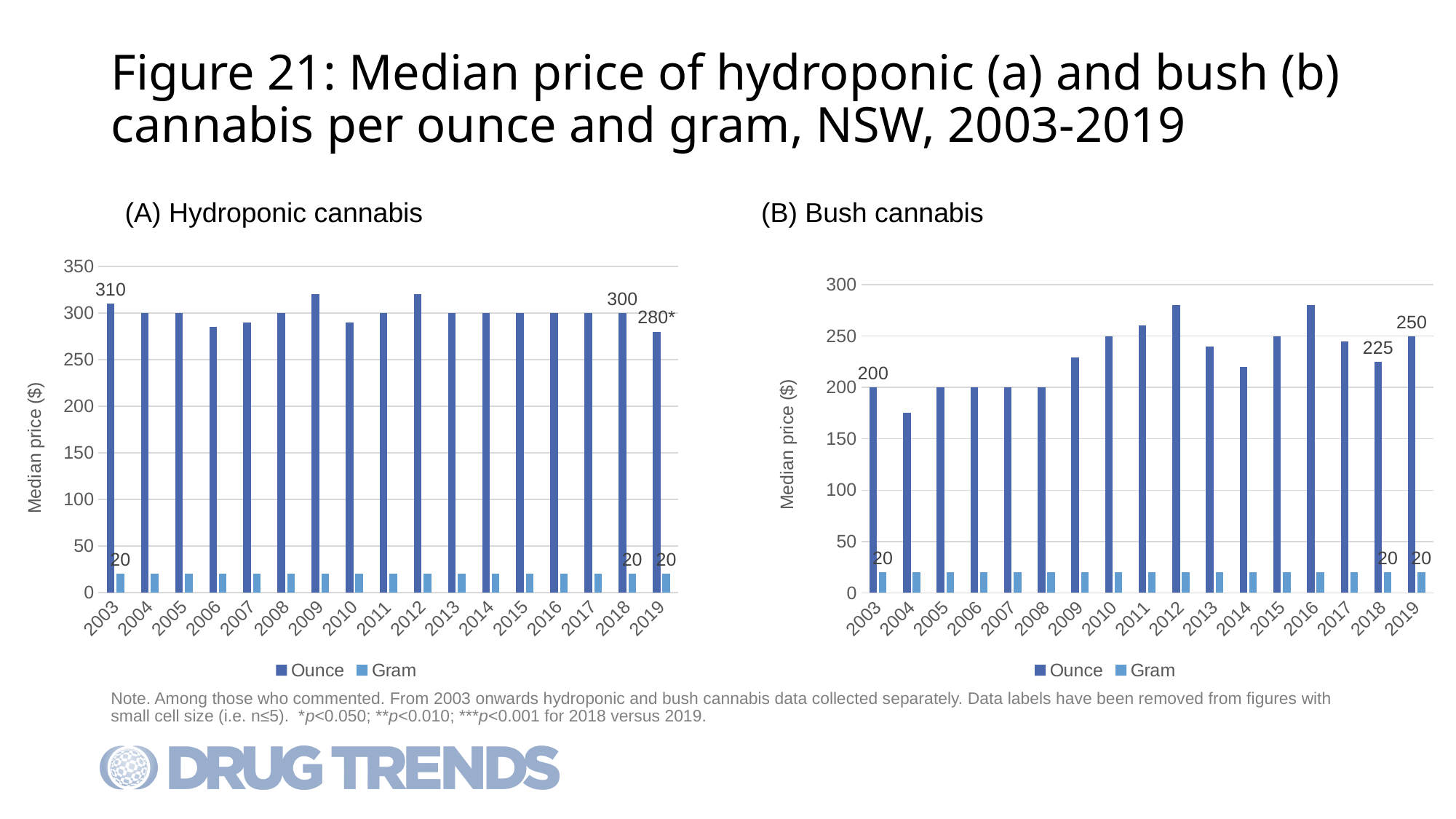
In the (B) Bush cannabis chart, what is the median price per gram in 2019? 20 In the (B) Bush cannabis chart, which year has the higher median ounce price, 2003 or 2019? 2019 How many years are shown on the x axis of the (A) Hydroponic cannabis chart? 17 What type of chart is the (A) Hydroponic cannabis chart? Bar chart In the (A) Hydroponic cannabis chart, what is the median price per ounce in 2003? 310 In the (A) Hydroponic cannabis chart, is the median ounce price for 2009 greater or less than 300? greater In the (A) Hydroponic cannabis chart, what is the median price per ounce in 2019? 280* In the (A) Hydroponic cannabis chart, what is the difference between the 2003 and 2019 median ounce prices? 30 How many series does the legend of the (B) Bush cannabis chart list? 2 In the (B) Bush cannabis chart, is the median ounce price for 2004 greater or less than 200? less In the (B) Bush cannabis chart, what is the difference between the 2019 and 2018 median ounce prices? 25 In the (B) Bush cannabis chart, what is the median price per ounce in 2018? 225